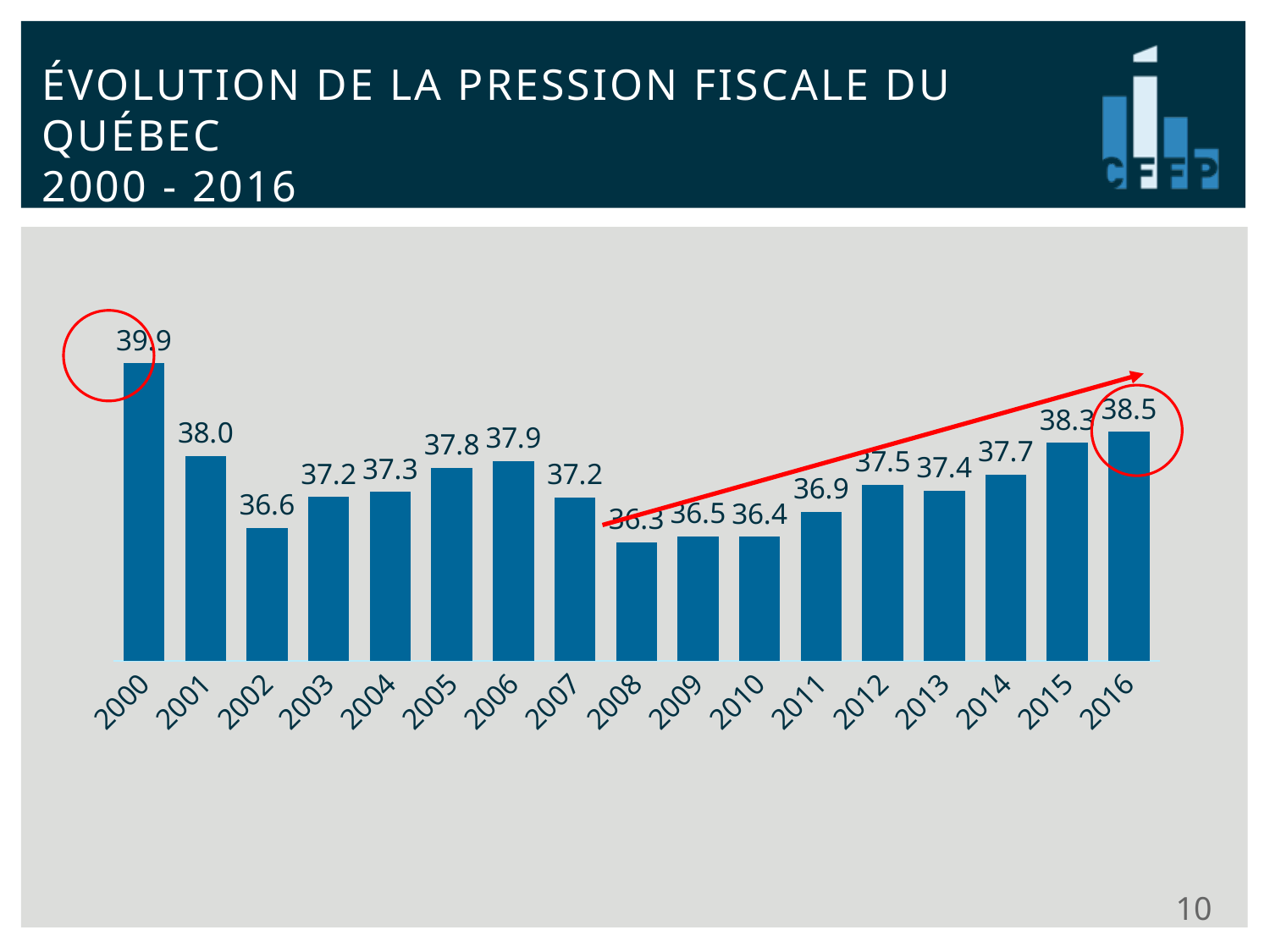
What is the value for 2011? 36.9 What is the value for 2008? 36.3 Do the values rise or fall from 2008 to 2016? Rise How many years are shown on the x axis? 17 What kind of chart is shown on the slide? Bar chart Which year has the lowest value? 2008 What is the difference between the values for 2000 and 2016? 1.4 What is the value for 2016? 38.5 Which is larger, the value for 2001 or the value for 2015? 2015 What is the difference between the values for 2016 and 2008? 2.2 Which year has the highest value? 2000 What is the value for 2000? 39.9